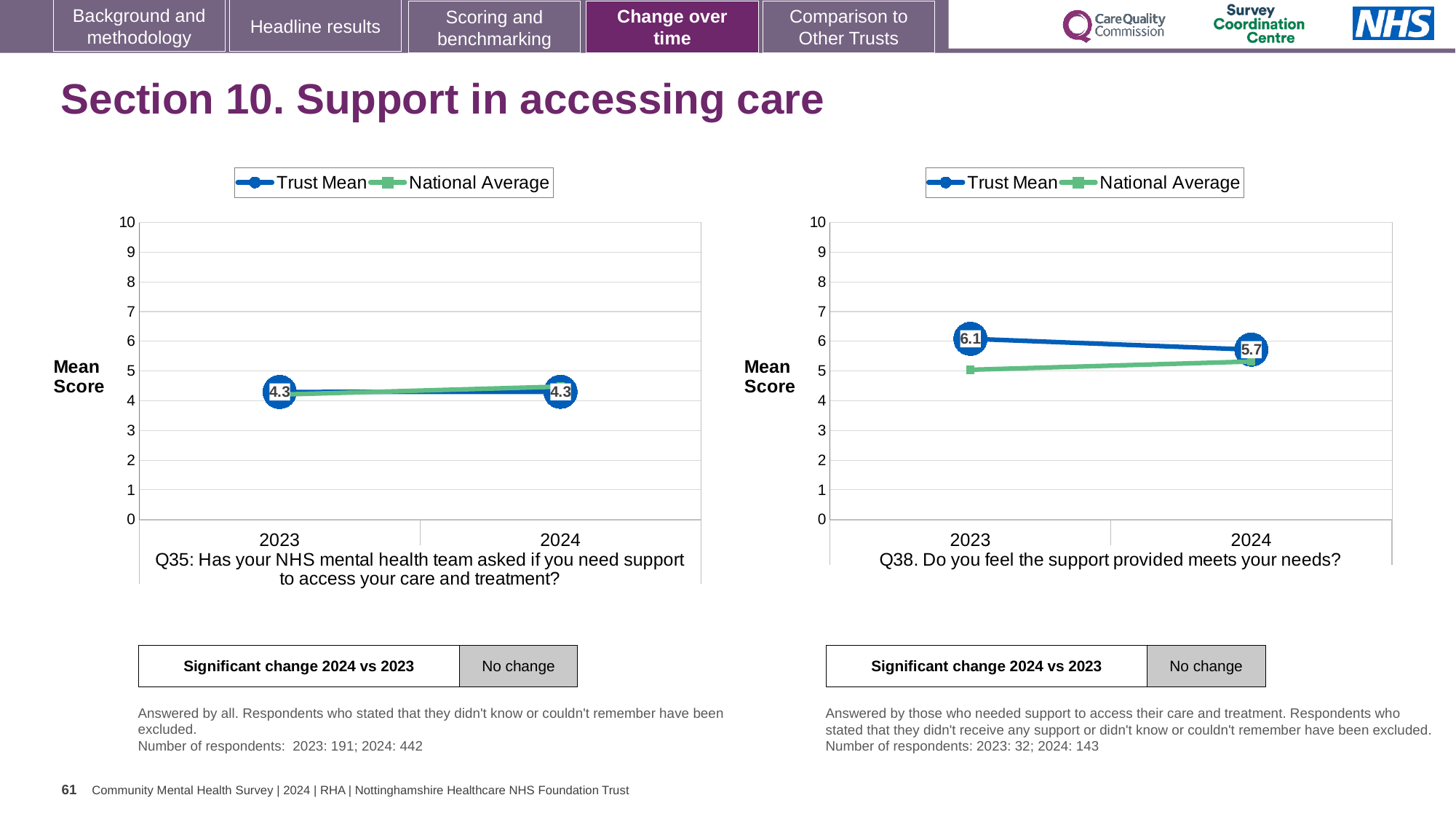
In the Q38 chart on the right, what is the Trust Mean score for 2024? 5.7 In the Q35 chart on the left, what is the Trust Mean score for 2023? 4.3 In the Q38 chart on the right, does the Trust Mean line rise or fall from 2023 to 2024? fall How many years are shown on the x axis of the Q38 chart on the right? 2 In the Q38 chart on the right, is the National Average value for 2023 greater or less than 6? less What type of chart is the Q35 chart on the left? line chart How many series does the legend of the Q35 chart on the left list? 2 In the Q38 chart on the right, is the National Average value for 2024 greater or less than 6? less In the Q38 chart on the right, by how much did the Trust Mean score fall from 2023 to 2024? 0.4 In the Q38 chart on the right, which year has the higher Trust Mean score, 2023 or 2024? 2023 In the Q38 chart on the right, what is the Trust Mean score for 2023? 6.1 In the Q35 chart on the left, what is the Trust Mean score for 2024? 4.3